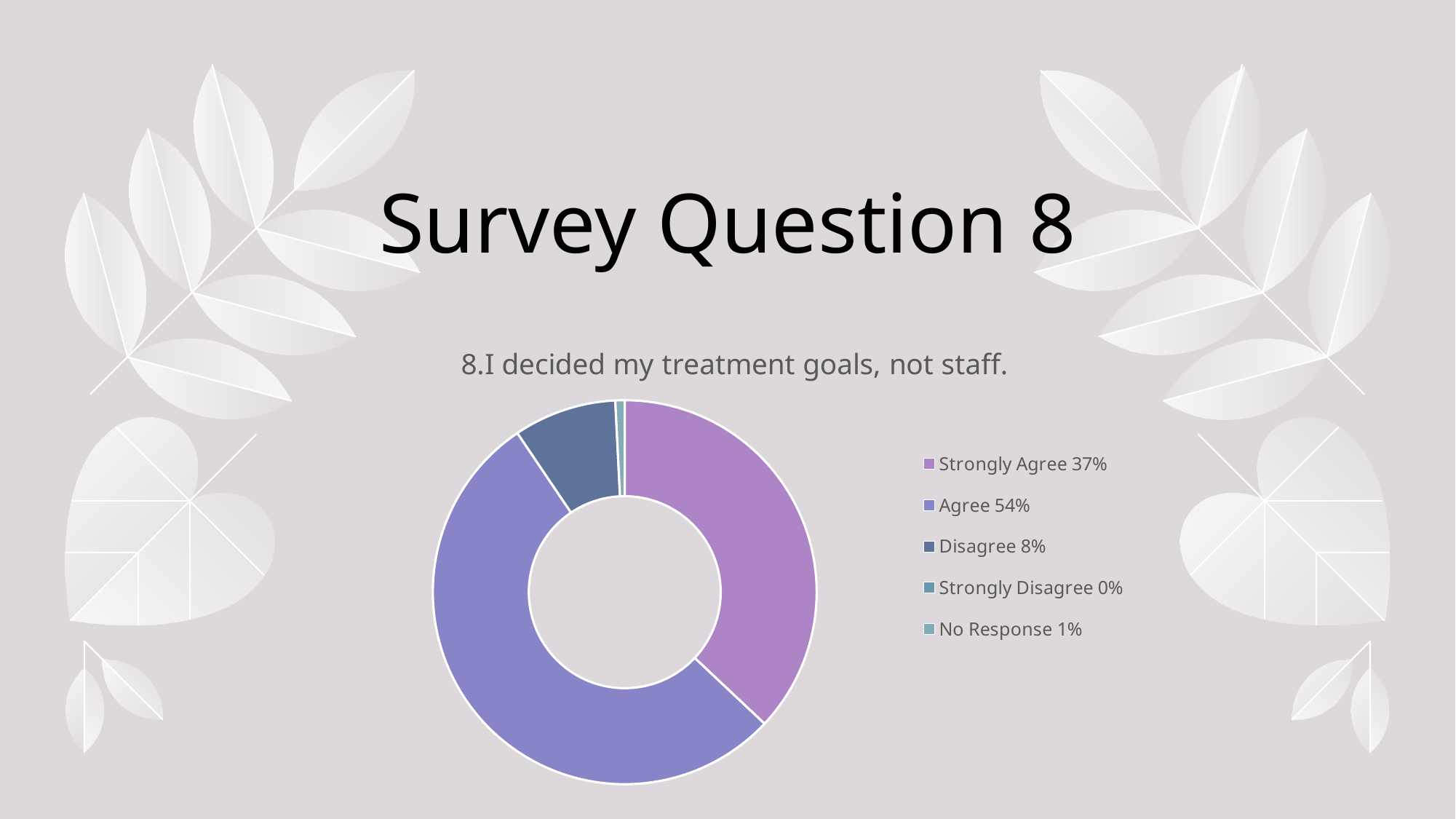
What percentage is shown for No Response? 1% What is the title of the chart? 8.I decided my treatment goals, not staff. What is the difference in percentage points between Agree and Strongly Agree? 17 Which response category has the smallest share? Strongly Disagree What is the combined percentage for Strongly Agree and Agree? 91% Which response category has the largest share? Agree What kind of chart is shown on the slide? Doughnut chart What percentage of respondents chose Agree? 54% What percentage of respondents chose Strongly Agree? 37% Which is larger, the share for Disagree or the share for No Response? Disagree How many response categories does the legend list? 5 What percentage of respondents chose Disagree? 8%